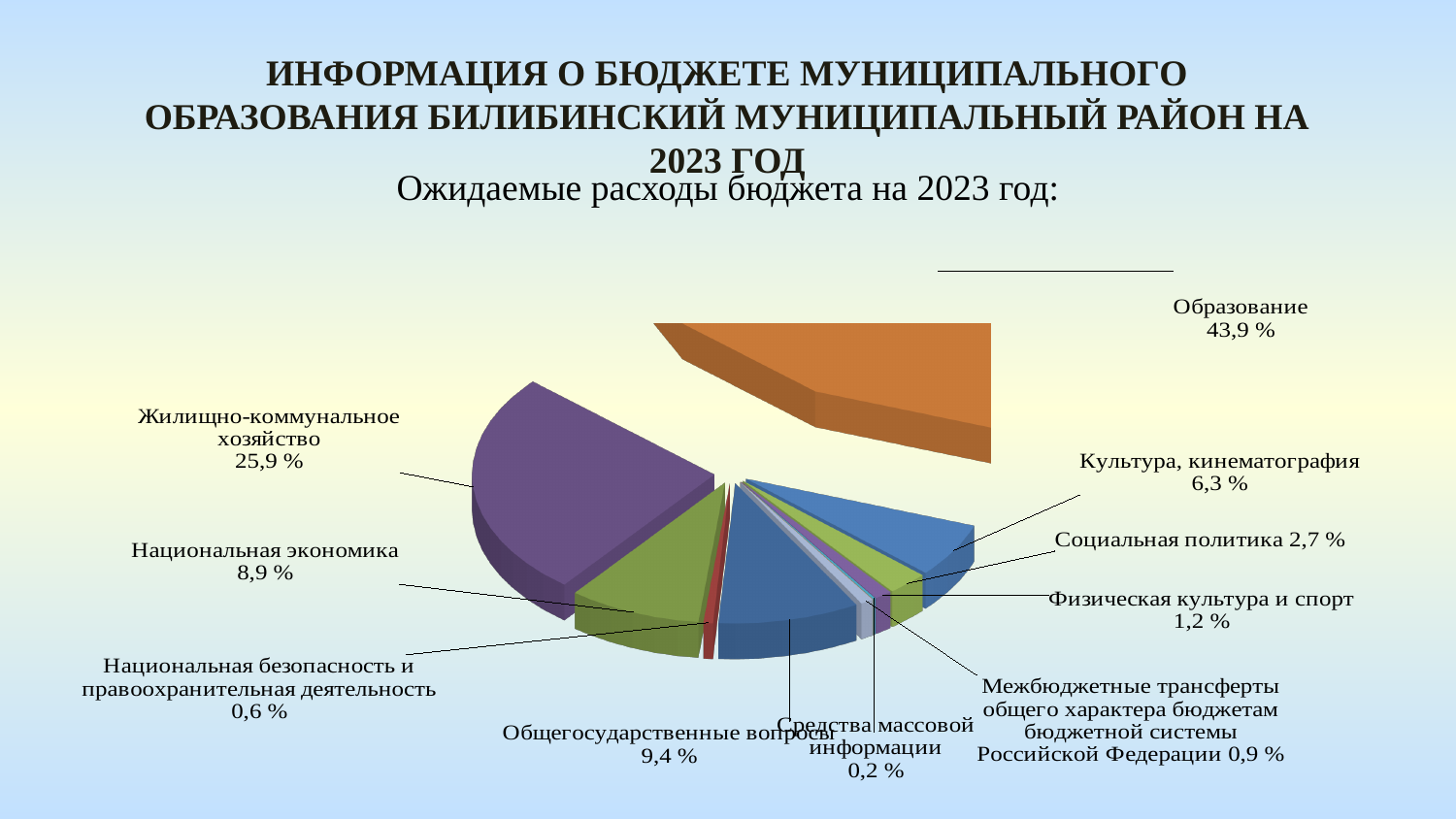
What is the difference in percentage points between Образование and Жилищно-коммунальное хозяйство? 18,0 percentage points Which is larger: the share for Национальная экономика or the share for Общегосударственные вопросы? Общегосударственные вопросы Which category has the largest share of the pie? Образование What share of the pie is labelled Жилищно-коммунальное хозяйство? 25,9 % What percentage is shown for Общегосударственные вопросы? 9,4 % Which is larger: the share for Социальная политика or the share for Физическая культура и спорт? Социальная политика How many categories are shown in the pie chart? 10 Which category has the smallest share of the pie? Средства массовой информации What is the subtitle above the chart? Ожидаемые расходы бюджета на 2023 год: What share of expected 2023 budget expenditures goes to Образование? 43,9 % What percentage is shown for Культура, кинематография? 6,3 % What type of chart is shown on the slide? Pie chart